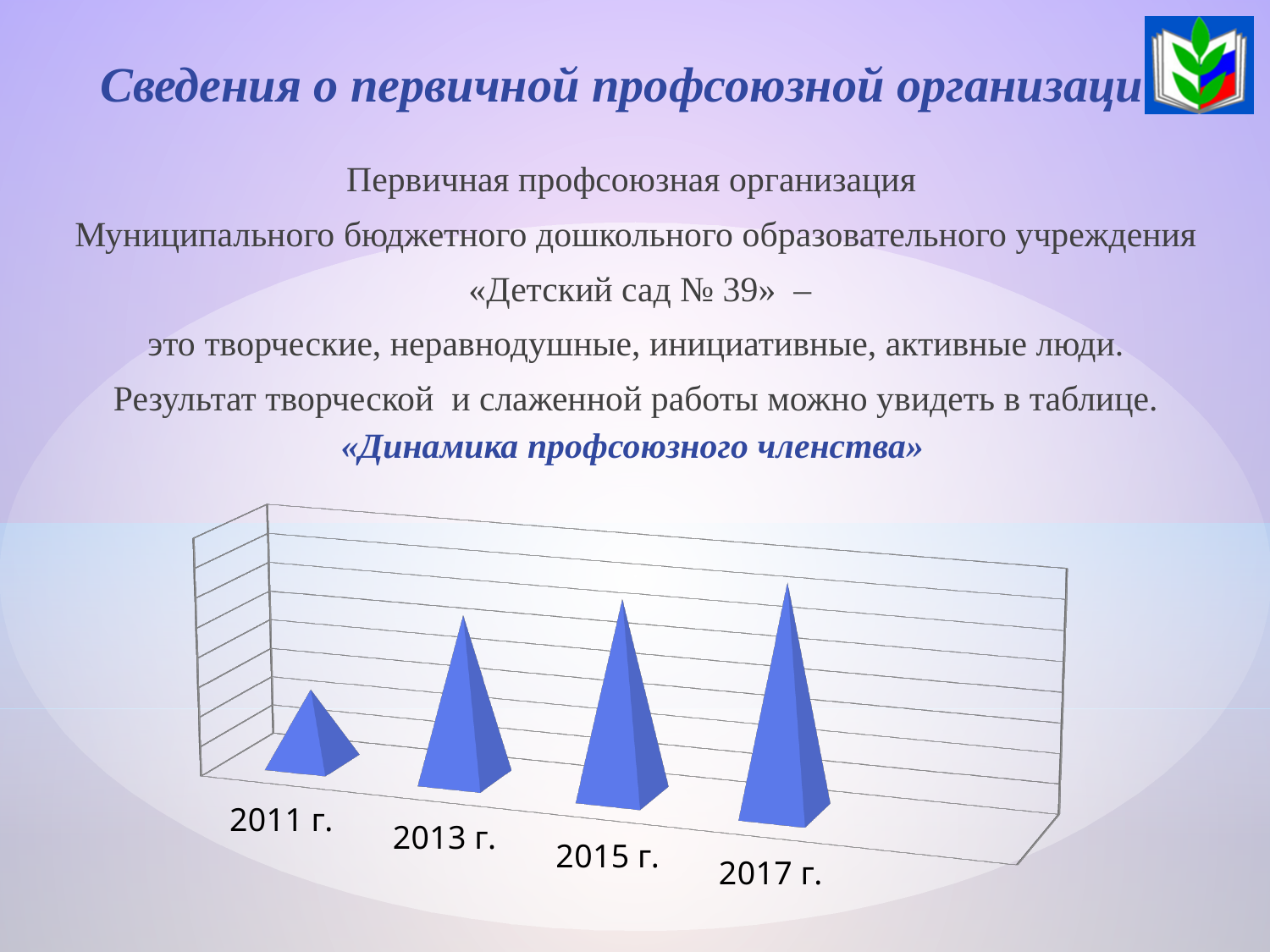
Which is larger, the value for 2011 г. or the value for 2015 г.? 2015 г. Which is larger, the value for 2013 г. or the value for 2017 г.? 2017 г. Which category has the lowest value in the chart? 2011 г. Which category has the highest value in the chart? 2017 г. What title is given above the chart on the slide? «Динамика профсоюзного членства» How many categories are shown on the x axis of the chart? 4 Do the values rise or fall from 2011 г. to 2017 г. along the x axis? rise Which is larger, the value for 2011 г. or the value for 2013 г.? 2013 г. What is the first category label on the x axis of the chart? 2011 г. What kind of chart is shown on the slide? bar chart